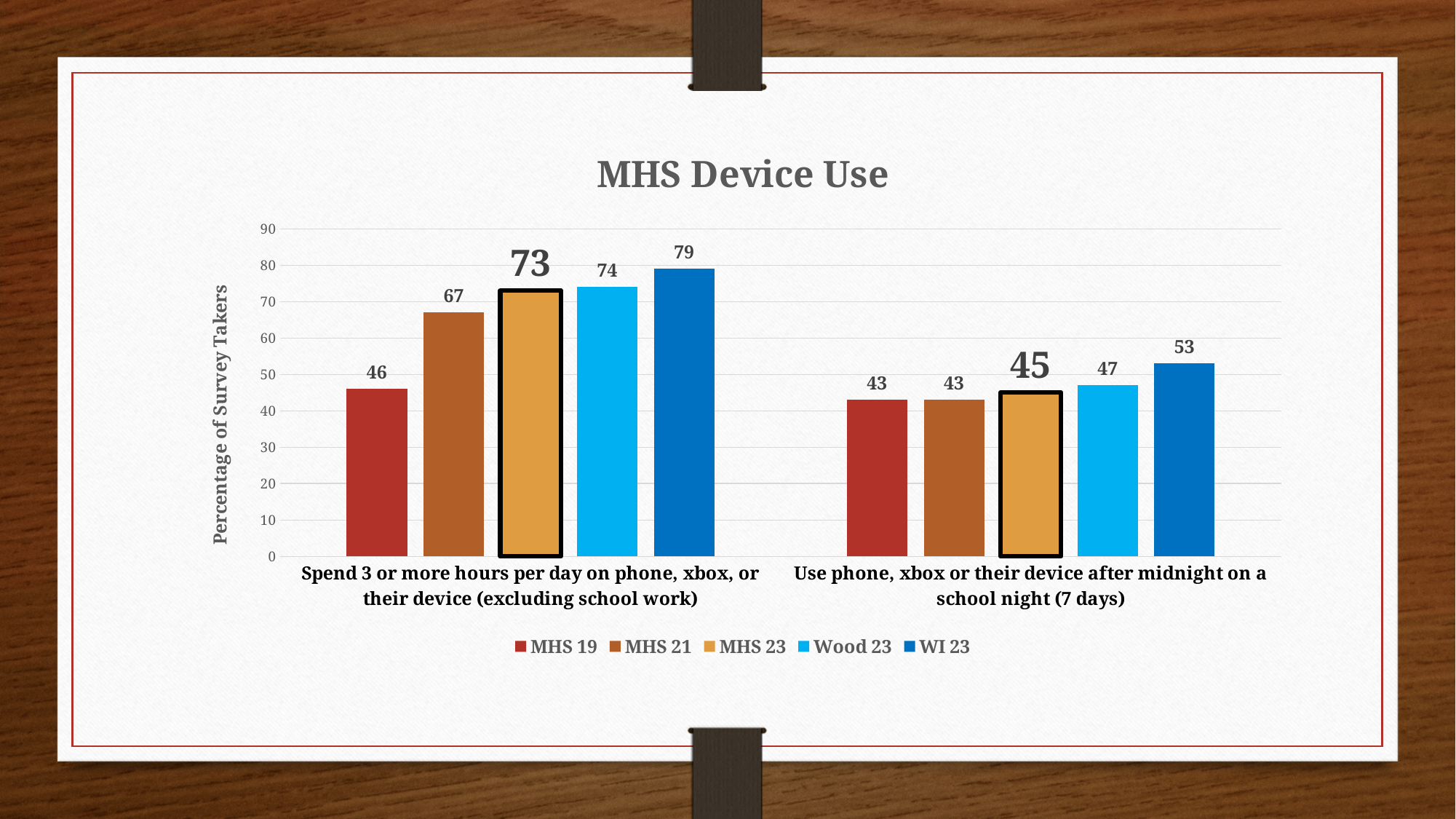
What kind of chart is shown on the slide? Bar chart Which series has the lowest value in the 'Spend 3 or more hours per day' category? MHS 19 Which series has the highest value in the 'Spend 3 or more hours per day' category? WI 23 What is the difference between the MHS 21 and MHS 19 values in the 'Spend 3 or more hours per day' category? 21 How many series does the legend list? 5 Which is larger in the 'Use phone, xbox or their device after midnight' category: MHS 23 or Wood 23? Wood 23 What is the difference between the WI 23 and Wood 23 values in the 'Use phone, xbox or their device after midnight' category? 6 What is the title of the chart? MHS Device Use What is the value for MHS 19 in the 'Spend 3 or more hours per day' category? 46 What is the value for MHS 23 in the 'Spend 3 or more hours per day on phone, xbox, or their device (excluding school work)' category? 73 What is the value for WI 23 in the 'Use phone, xbox or their device after midnight on a school night (7 days)' category? 53 How many categories are shown on the x axis? 2